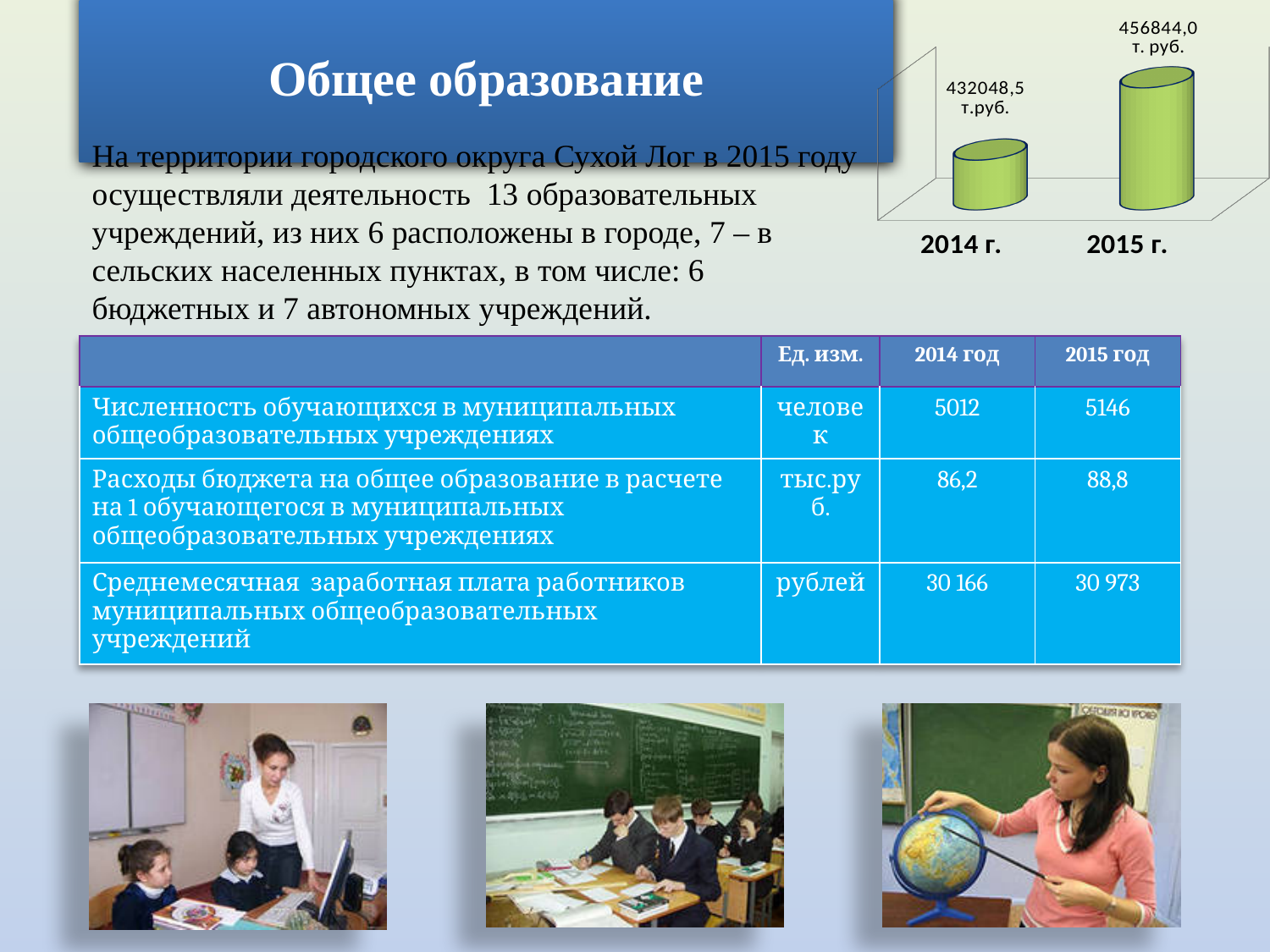
What value is shown for 2015 г. in the chart? 456844,0 т. руб. Do the values in the chart rise or fall from 2014 г. to 2015 г.? rise In what unit are the values in the chart labelled? т.руб. By how much does the value for 2015 г. exceed the value for 2014 г. in the chart? 24795,5 т.руб. What value is shown for 2014 г. in the chart? 432048,5 т.руб. What kind of chart is shown in the top right of the slide? bar chart Which year has the higher value in the chart? 2015 г. Is the value for 2014 г. larger or smaller than the value for 2015 г. in the chart? smaller Which year has the lower value in the chart? 2014 г. What colour are the bars in the chart? green How many categories (years) are plotted in the chart? 2